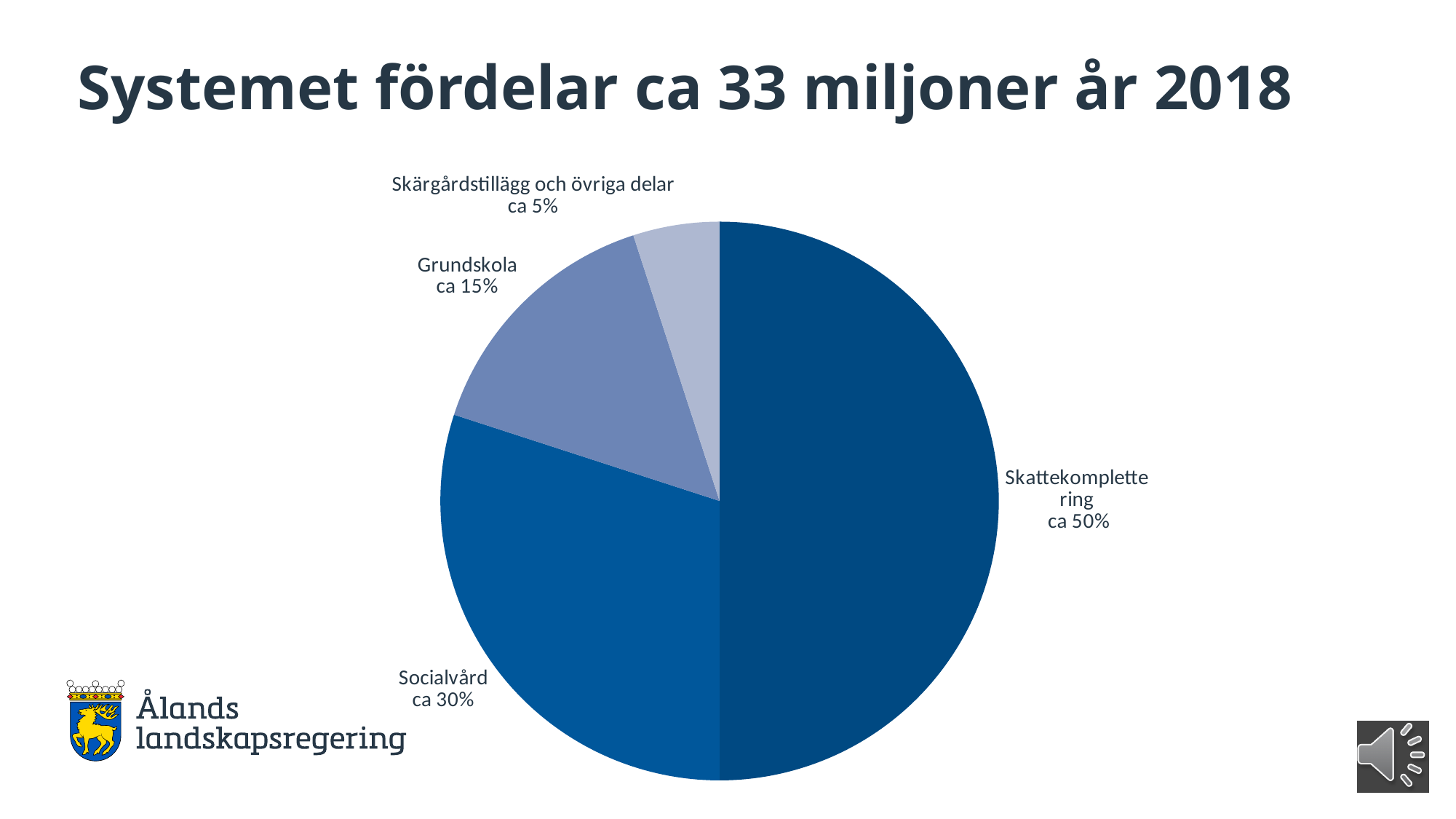
What is the difference in percentage points between the Skattekomplettering share and the Socialvård share? 20 percentage points What share of the pie does Skärgårdstillägg och övriga delar have? ca 5% Which slice of the pie is the smallest? Skärgårdstillägg och övriga delar What share of the pie does Socialvård have? ca 30% What is the title of the slide containing the pie chart? Systemet fördelar ca 33 miljoner år 2018 What kind of chart is shown on the slide? pie chart Which slice of the pie is shown in the lightest colour? Skärgårdstillägg och övriga delar What share of the pie does Grundskola have? ca 15% How many slices does the pie chart have? 4 Which slice of the pie is the largest? Skattekomplettering Which is larger, the share for Socialvård or the share for Grundskola? Socialvård